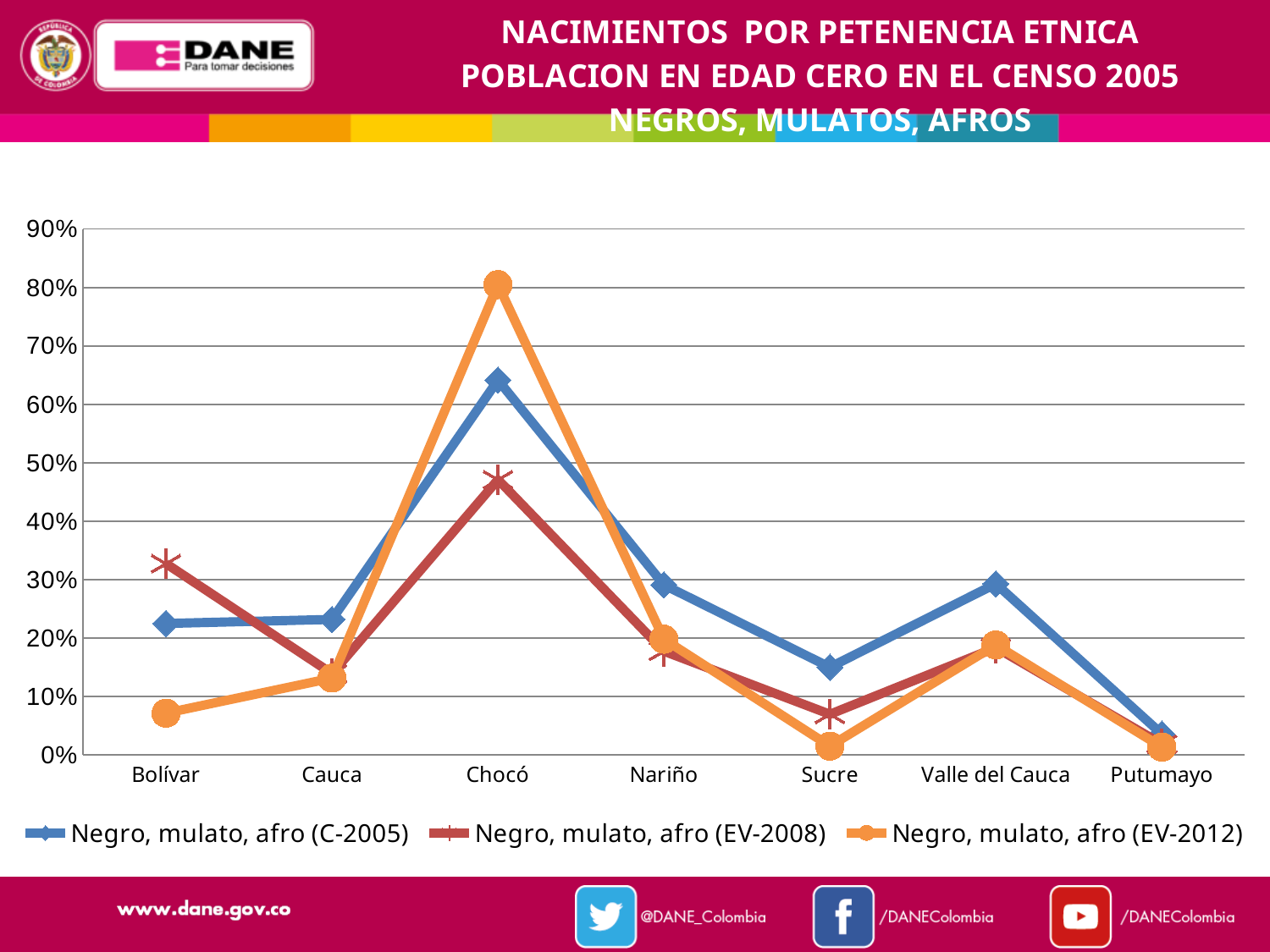
Is the value for Chocó in the Negro, mulato, afro (EV-2012) series greater or less than 70%? greater Does the Negro, mulato, afro (C-2005) series rise or fall from Valle del Cauca to Putumayo? fall For Bolívar, which series has the larger value: Negro, mulato, afro (C-2005) or Negro, mulato, afro (EV-2008)? Negro, mulato, afro (EV-2008) How many series does the legend list? 3 For Chocó, which series has the larger value: Negro, mulato, afro (EV-2012) or Negro, mulato, afro (EV-2008)? Negro, mulato, afro (EV-2012) Which department has the highest value for the Negro, mulato, afro (C-2005) series? Chocó How many departments are shown along the x axis? 7 Is the value for Bolívar in the Negro, mulato, afro (EV-2012) series greater or less than 10%? less What kind of chart is shown on the slide? line chart Is the value for Chocó in the Negro, mulato, afro (C-2005) series greater or less than 70%? less Which department has the lowest value for the Negro, mulato, afro (EV-2008) series? Putumayo Which department has the highest value for the Negro, mulato, afro (EV-2012) series? Chocó